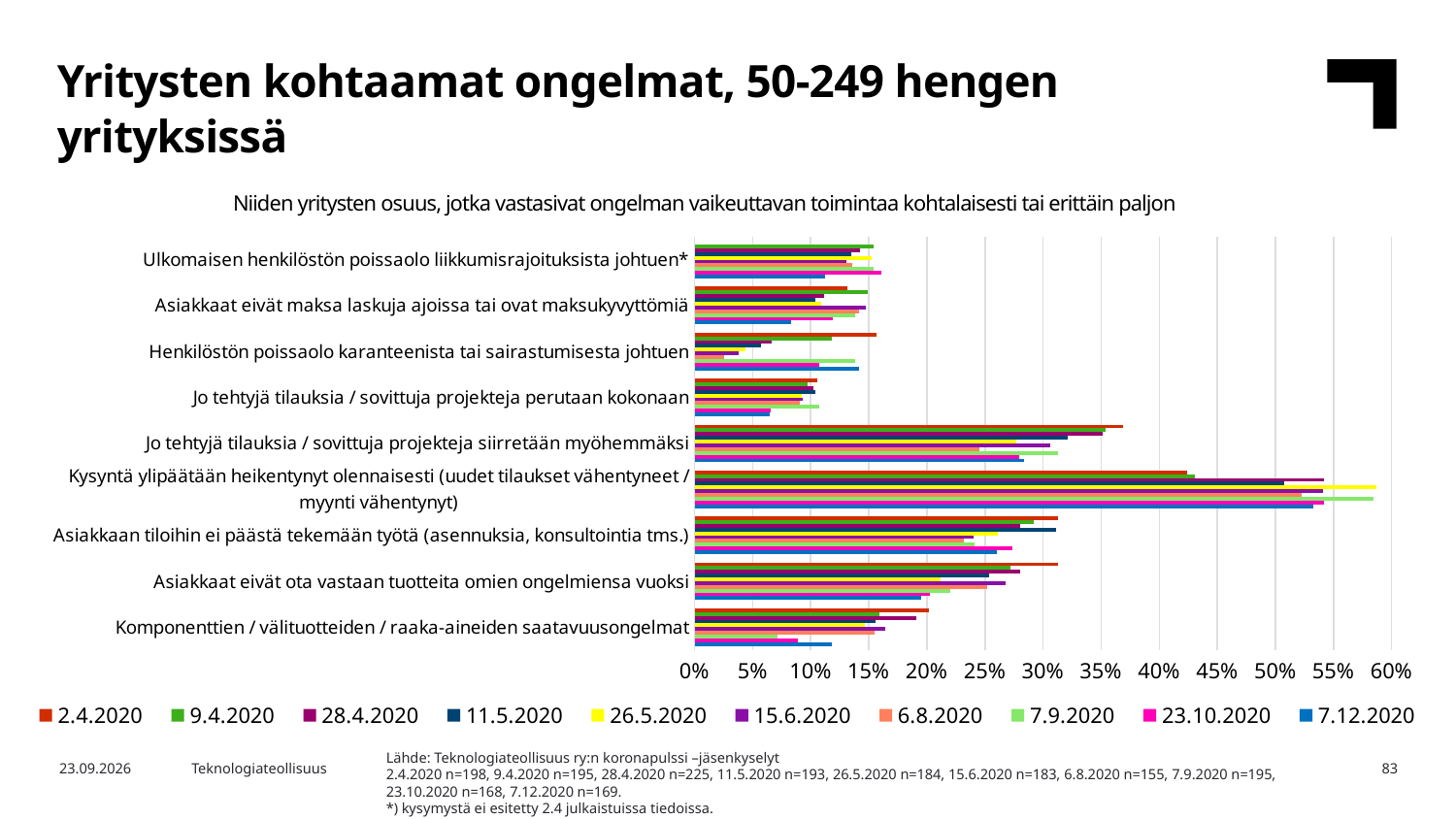
Which category has the highest values overall in the chart? Kysyntä ylipäätään heikentynyt olennaisesti (uudet tilaukset vähentyneet / myynti vähentynyt) How many series (survey dates) does the legend list? 10 Is the 2.4.2020 value for 'Asiakkaan tiloihin ei päästä tekemään työtä' greater or less than 25%? greater For 'Komponenttien / välituotteiden / raaka-aineiden saatavuusongelmat', which is larger: the 2.4.2020 value or the 23.10.2020 value? 2.4.2020 What kind of chart is shown on the slide? Bar chart For 'Kysyntä ylipäätään heikentynyt olennaisesti', which is larger: the 2.4.2020 value or the 26.5.2020 value? 26.5.2020 What is the highest value shown on the horizontal axis of the chart? 60% Which series is shown in yellow in the legend? 26.5.2020 Is the 7.12.2020 value for 'Komponenttien / välituotteiden / raaka-aineiden saatavuusongelmat' greater or less than 10%? greater How many categories (problem types) are listed on the vertical axis of the chart? 9 Is the 2.4.2020 value for 'Jo tehtyjä tilauksia / sovittuja projekteja siirretään myöhemmäksi' greater or less than 35%? greater